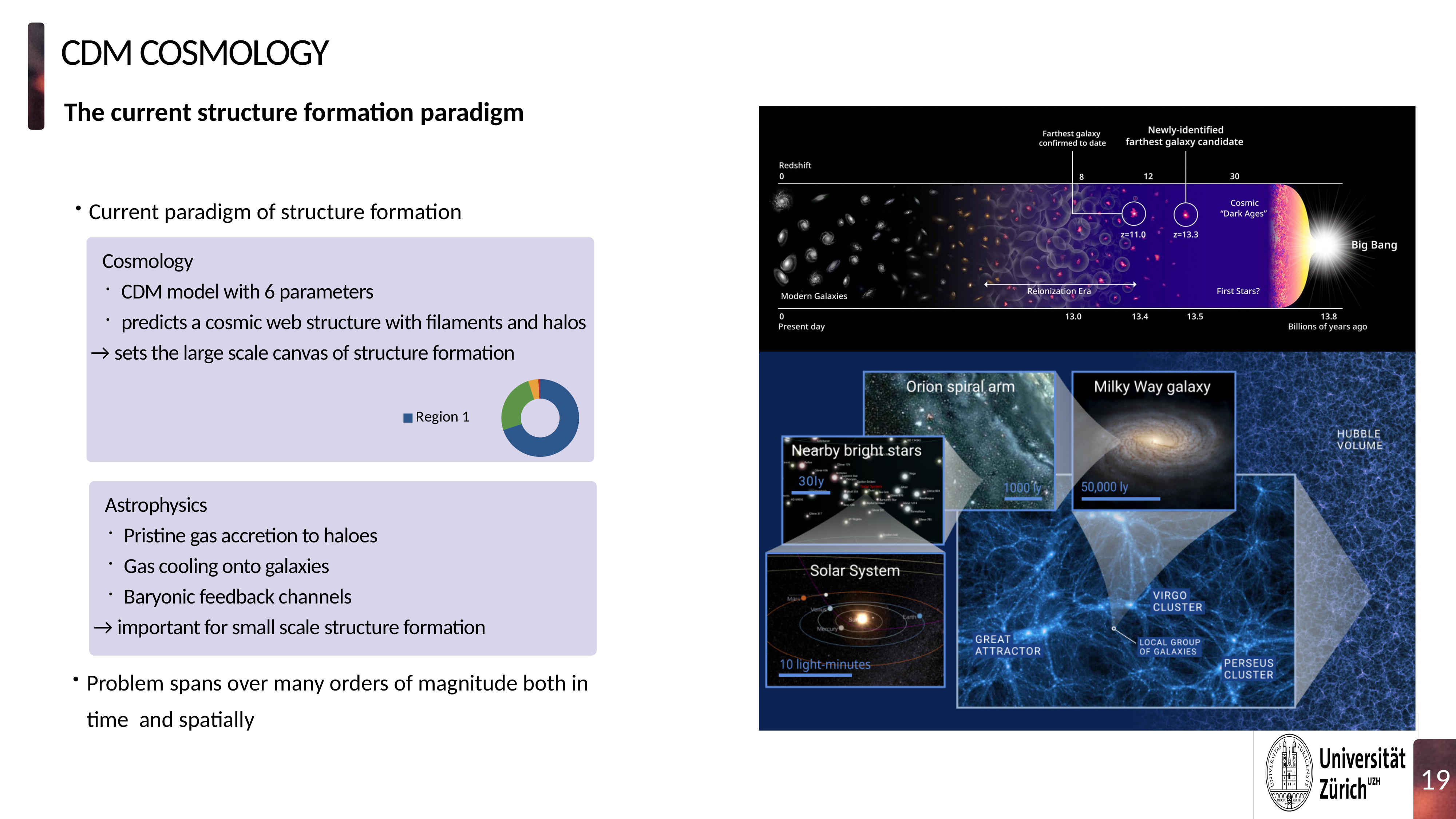
In the doughnut chart in the Cosmology box, which is larger, the green slice or the orange slice? green What colour is the slice that the legend entry 'Region 1' refers to in the doughnut chart? blue How many slices does the doughnut chart in the Cosmology box have? 4 How many entries does the legend of the doughnut chart in the Cosmology box list? 1 In the doughnut chart in the Cosmology box, which is larger, the blue slice or the green slice? blue In the doughnut chart in the Cosmology box, which colour slice is the largest? blue What is the legend entry shown next to the doughnut chart in the Cosmology box? Region 1 What kind of chart is shown inside the Cosmology box on the left of the slide? doughnut chart